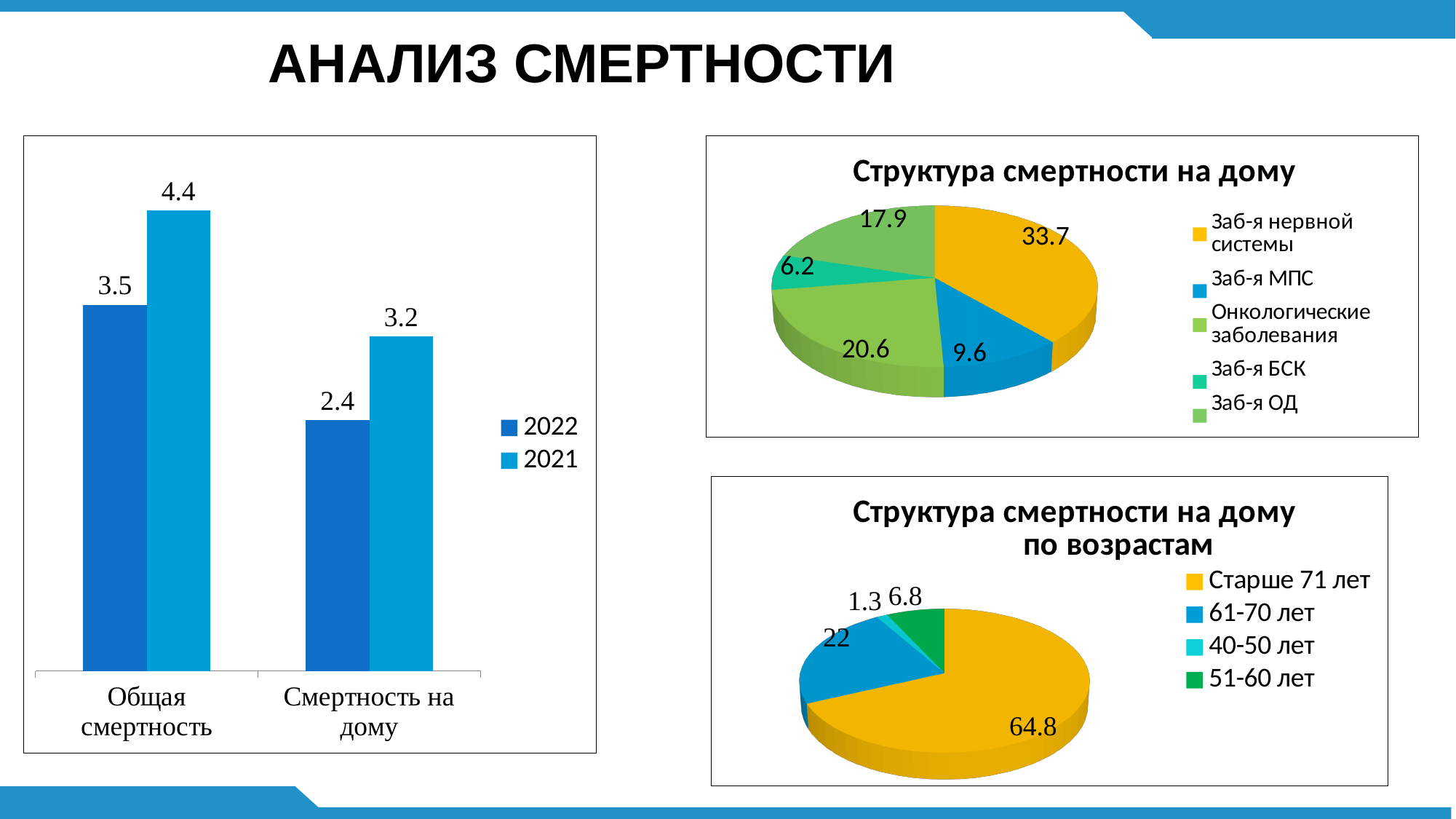
In the chart titled 'Структура смертности на дому', which category has the smallest slice? Заб-я БСК In the chart titled 'Структура смертности на дому по возрастам', which age group has the smallest slice? 40-50 лет In the bar chart on the left, what is the value for Смертность на дому in 2022? 2.4 How many series does the legend of the bar chart on the left list? 2 In the chart titled 'Структура смертности на дому по возрастам', what is the value for 61-70 лет? 22 In the bar chart on the left, what is the value for Общая смертность in 2021? 4.4 How many categories are shown in the chart titled 'Структура смертности на дому'? 5 In the bar chart on the left, what is the difference between the 2021 and 2022 values for Общая смертность? 0.9 What kind of chart is the chart on the left of the slide? Bar chart In the bar chart on the left, which year has the larger value for Смертность на дому, 2022 or 2021? 2021 In the chart titled 'Структура смертности на дому', what is the value for Онкологические заболевания? 20.6 In the chart titled 'Структура смертности на дому', which category has the largest slice? Заб-я нервной системы